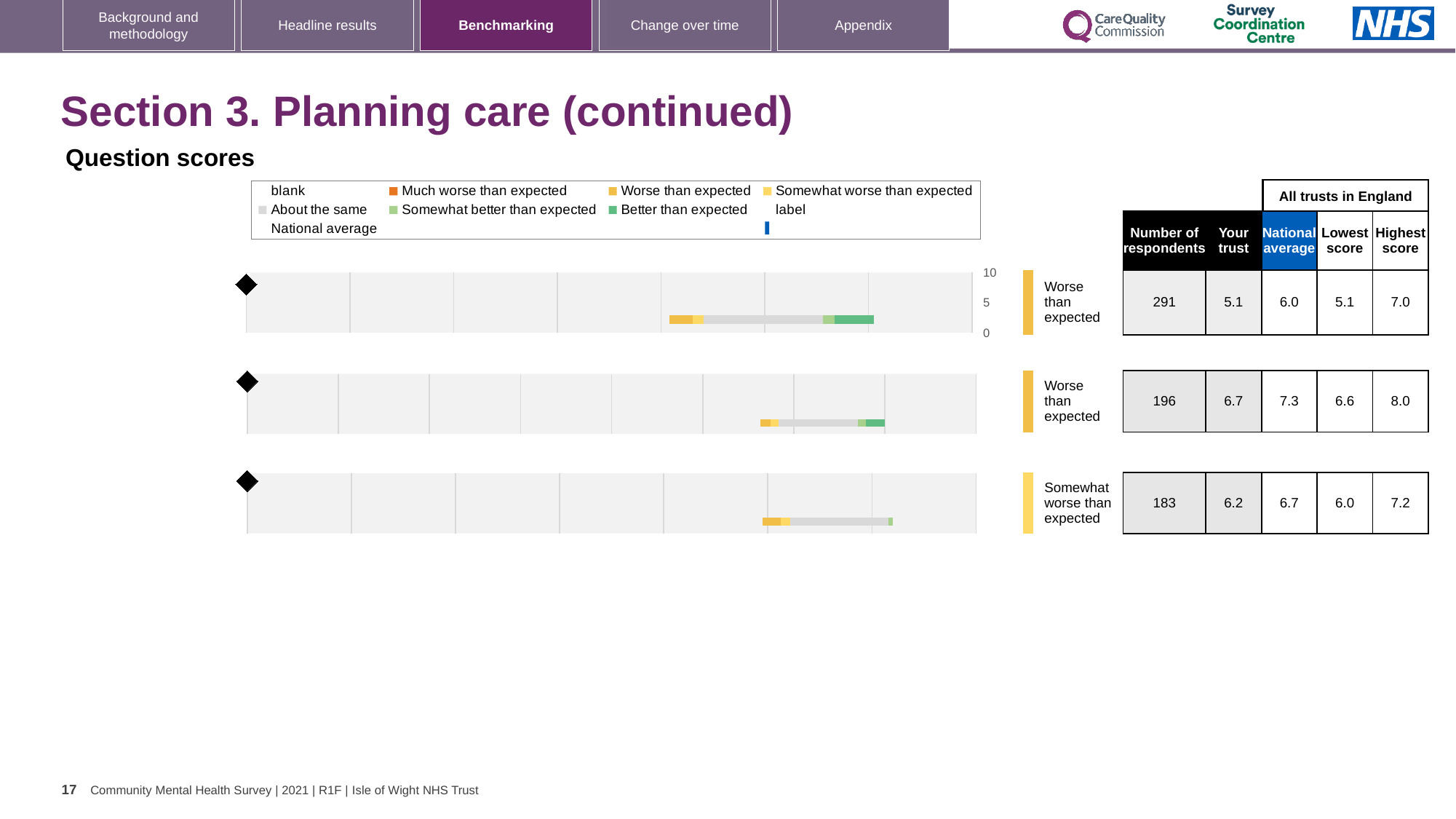
Which of the three charts has the lowest number of respondents? the bottom chart (183) For the bottom chart, what is the highest score among all trusts in England? 7.2 What benchmark category label is shown next to the bottom chart? Somewhat worse than expected What is the maximum value shown on the vertical axis of the top chart? 10 Which of the three charts has the highest 'Your trust' score? the middle chart (6.7) For the middle chart, what is the difference between the national average and the 'Your trust' score? 0.6 How many benchmark charts are shown on the slide? 3 What kind of chart is used for each of the three benchmark rows on the slide? bar chart For the top chart, what is the difference between the national average and the 'Your trust' score? 0.9 For the middle chart, how many respondents are listed? 196 For the top chart, what is the 'Your trust' score shown in the table? 5.1 For the top chart, what is the national average score? 6.0